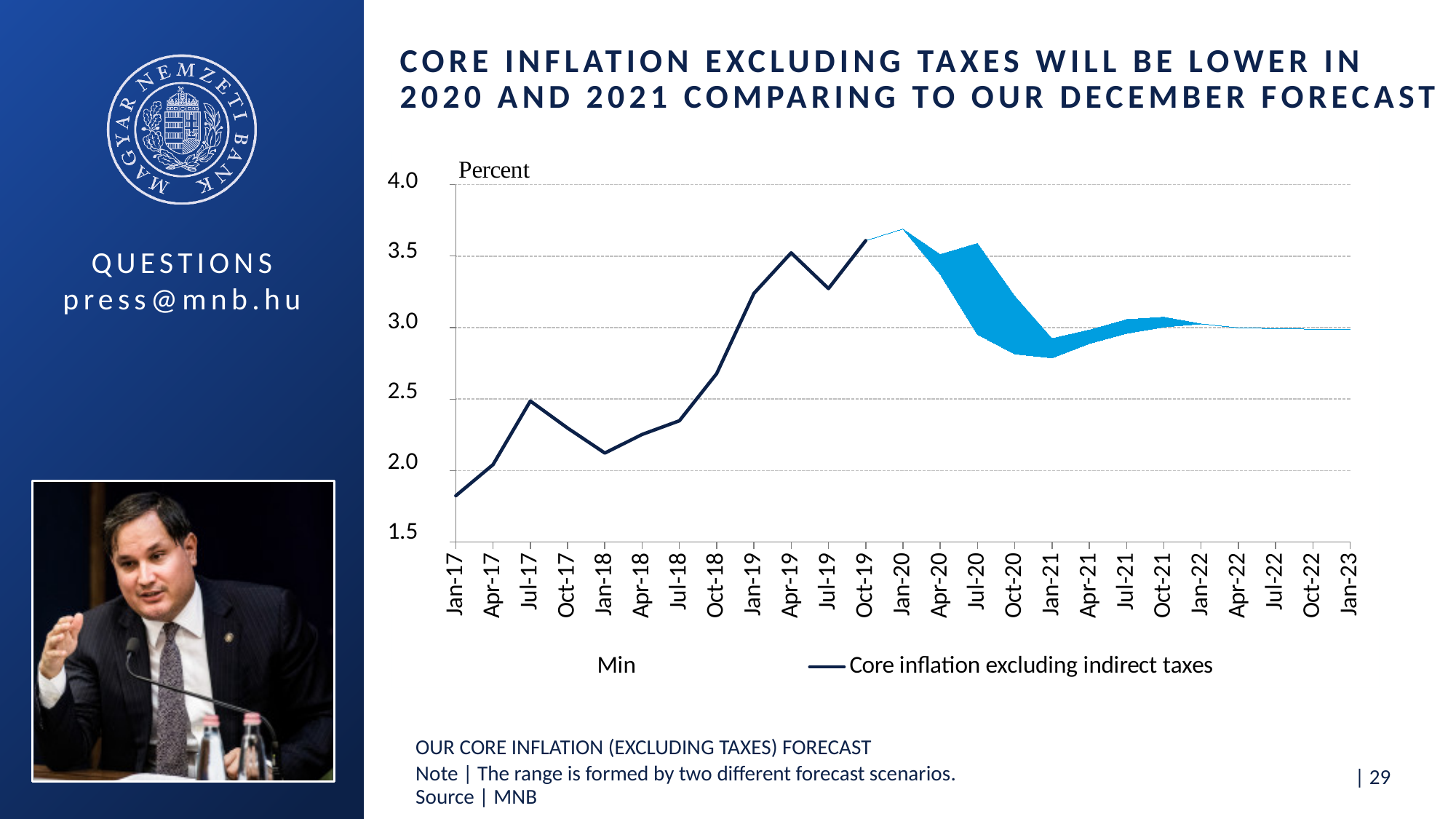
What unit label is shown at the top of the y axis? Percent What kind of chart is shown on the slide? combination line and area chart (a line with a shaded forecast range) Is the value of core inflation excluding indirect taxes for Oct-18 greater or less than 2.5? greater At which x-axis date is the core inflation excluding indirect taxes line at its lowest? Jan-17 Which is larger, the core inflation excluding indirect taxes value for Apr-19 or for Jul-19? Apr-19 How many date labels are shown along the x axis? 25 Is the value of core inflation excluding indirect taxes for Jan-19 greater or less than 3.0? greater How many entries does the chart legend list? 2 What are the two entries in the chart legend? Min; Core inflation excluding indirect taxes Is the value of core inflation excluding indirect taxes for Jul-19 greater or less than 3.5? less Which is larger, the core inflation excluding indirect taxes value for Jul-17 or for Jan-18? Jul-17